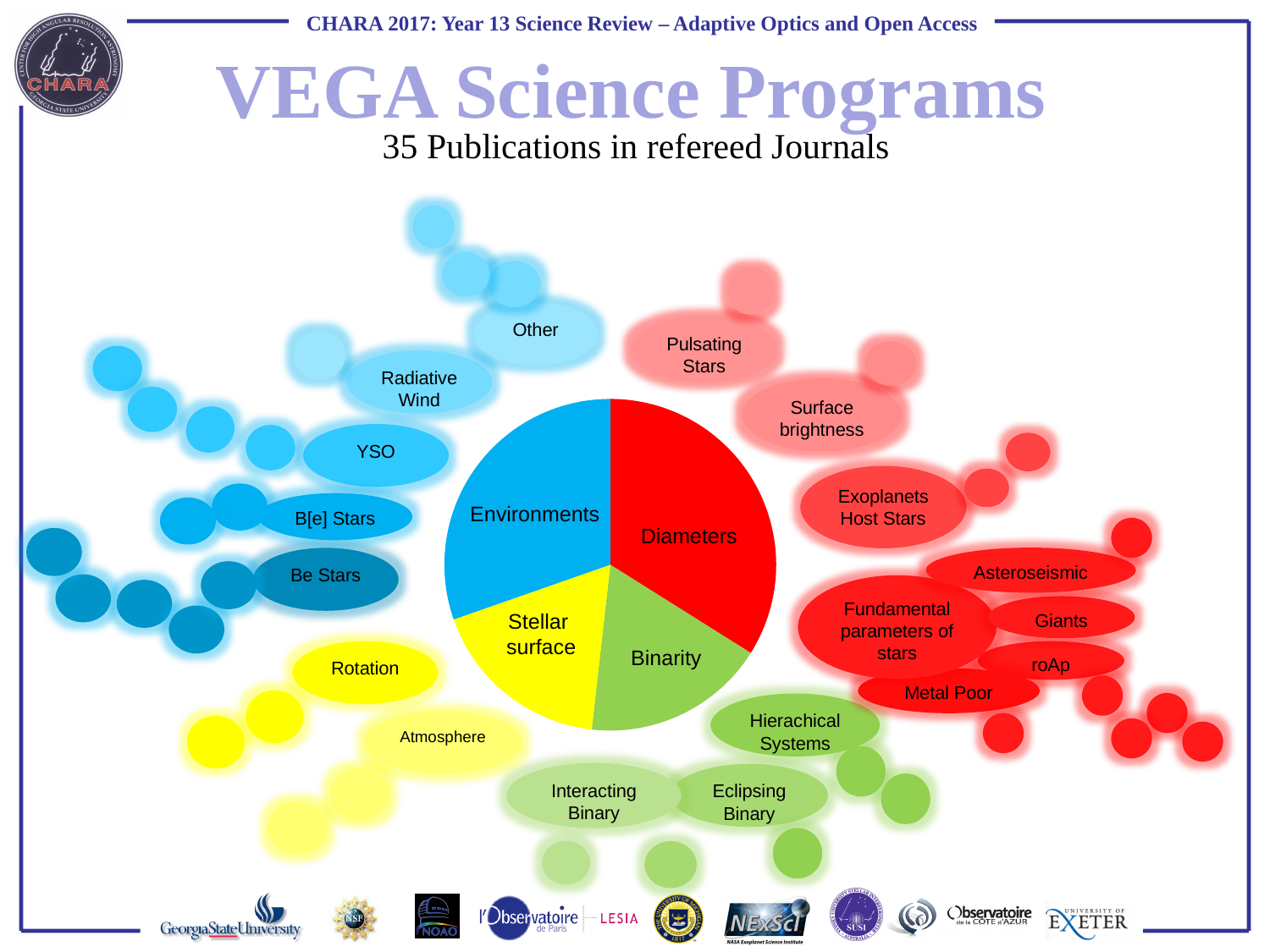
What colour is the Diameters slice of the pie chart? red In the pie chart, which slice is larger, Diameters or Binarity? Diameters What is the title of the slide containing the pie chart? VEGA Science Programs How many slices does the pie chart have? 4 What kind of chart is shown in the centre of the slide? pie chart In the pie chart, which slice is larger, Environments or Stellar surface? Environments